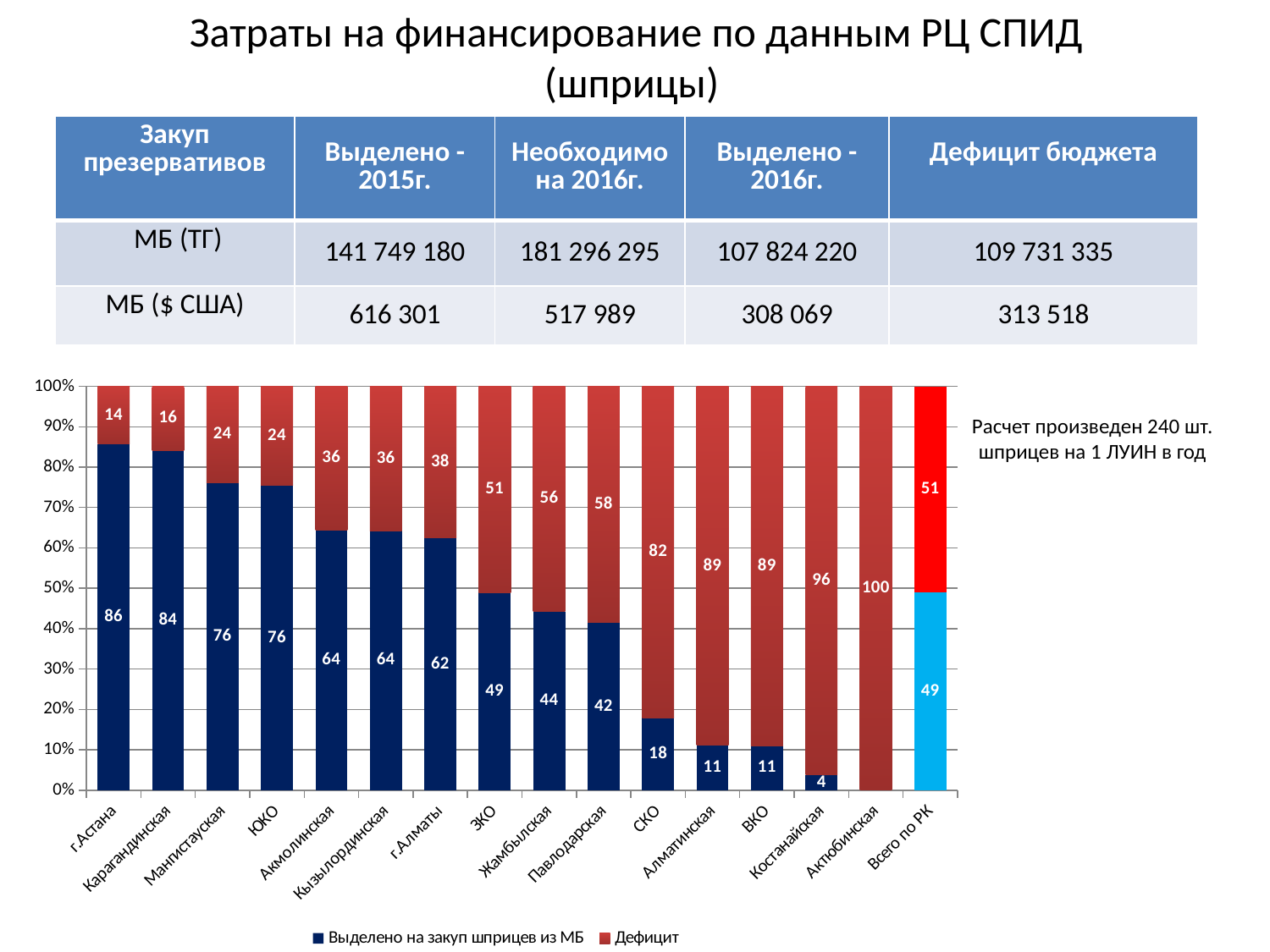
What is the 'Дефицит' value labelled for Актюбинская? 100 What value is labelled for г.Астана in the 'Выделено на закуп шприцев из МБ' series? 86 Which region has the highest 'Дефицит' value? Актюбинская What kind of chart is shown on the slide? Stacked bar chart How many categories are shown on the x axis of the chart? 16 What is the difference between the 'Дефицит' values for СКО and ЗКО? 31 Which region has the lowest 'Дефицит' value? г.Астана What is the name of the second series in the chart legend? Дефицит How many series does the chart legend list? 2 Which is larger, the 'Выделено на закуп шприцев из МБ' value for Жамбылская or for Костанайская? Жамбылская What is the 'Выделено на закуп шприцев из МБ' value labelled for Всего по РК? 49 What is the 'Дефицит' value labelled for Павлодарская? 58